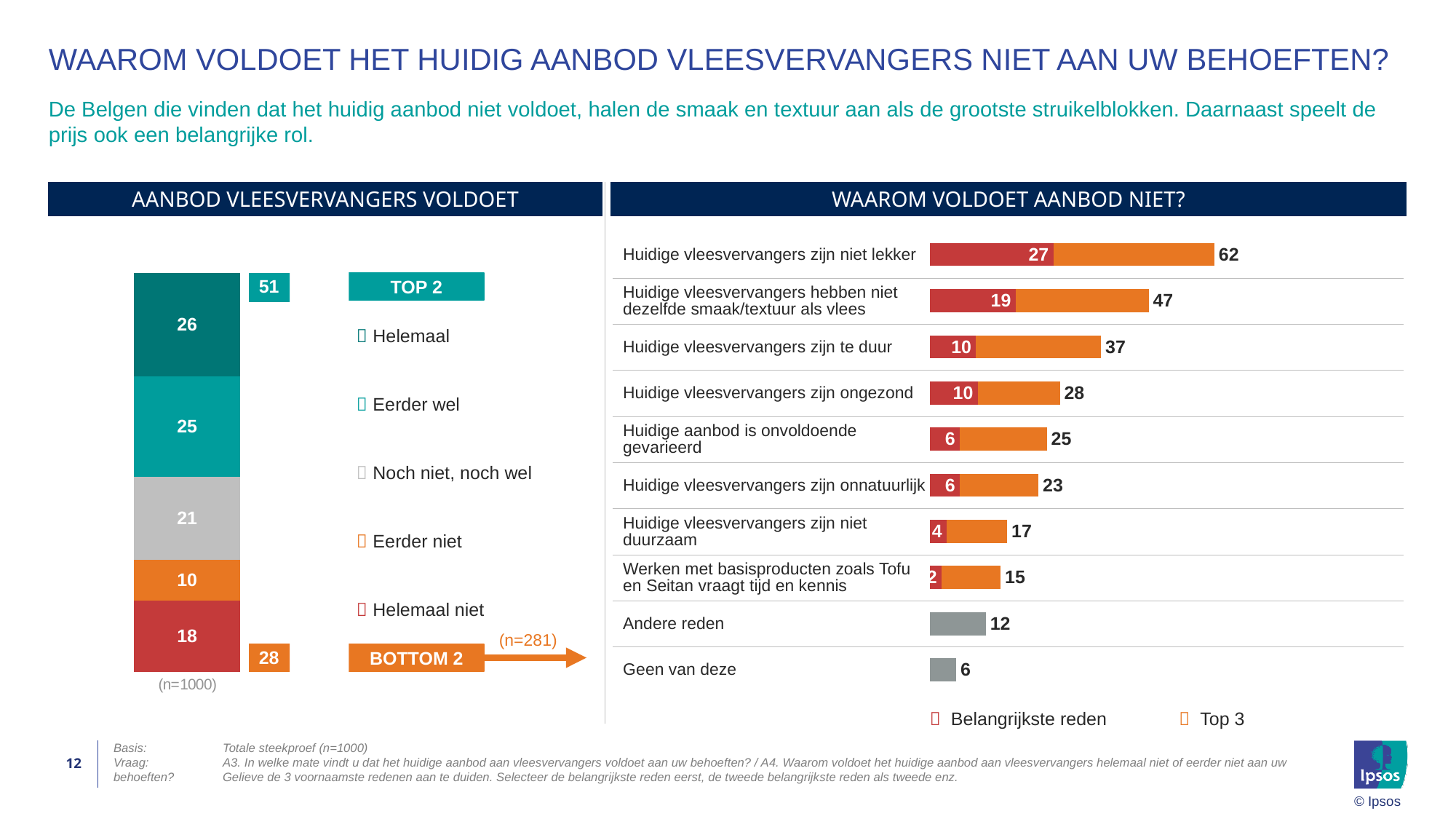
In the chart 'WAAROM VOLDOET AANBOD NIET?', what is the 'Belangrijkste reden' value for 'Huidige vleesvervangers zijn te duur'? 10 In the chart 'WAAROM VOLDOET AANBOD NIET?', what is the Top 3 value for 'Huidige vleesvervangers zijn niet lekker'? 62 How many reasons (categories) are listed in the chart 'WAAROM VOLDOET AANBOD NIET?'? 10 How many series does the legend of the chart 'WAAROM VOLDOET AANBOD NIET?' list? 2 In the chart 'WAAROM VOLDOET AANBOD NIET?', what is the difference between the Top 3 values for 'Huidige vleesvervangers zijn niet lekker' and 'Huidige vleesvervangers hebben niet dezelfde smaak/textuur als vlees'? 15 In the chart 'AANBOD VLEESVERVANGERS VOLDOET', which is larger: 'Eerder wel' or 'Helemaal niet'? Eerder wel What kind of chart is 'WAAROM VOLDOET AANBOD NIET?'? bar chart In the chart 'WAAROM VOLDOET AANBOD NIET?', which category has the lowest value? Geen van deze In the chart 'AANBOD VLEESVERVANGERS VOLDOET', what is the value for 'Helemaal'? 26 In the chart 'AANBOD VLEESVERVANGERS VOLDOET', what is the TOP 2 value? 51 In the chart 'AANBOD VLEESVERVANGERS VOLDOET', what is the BOTTOM 2 value? 28 In the chart 'WAAROM VOLDOET AANBOD NIET?', which reason has the highest Top 3 value? Huidige vleesvervangers zijn niet lekker